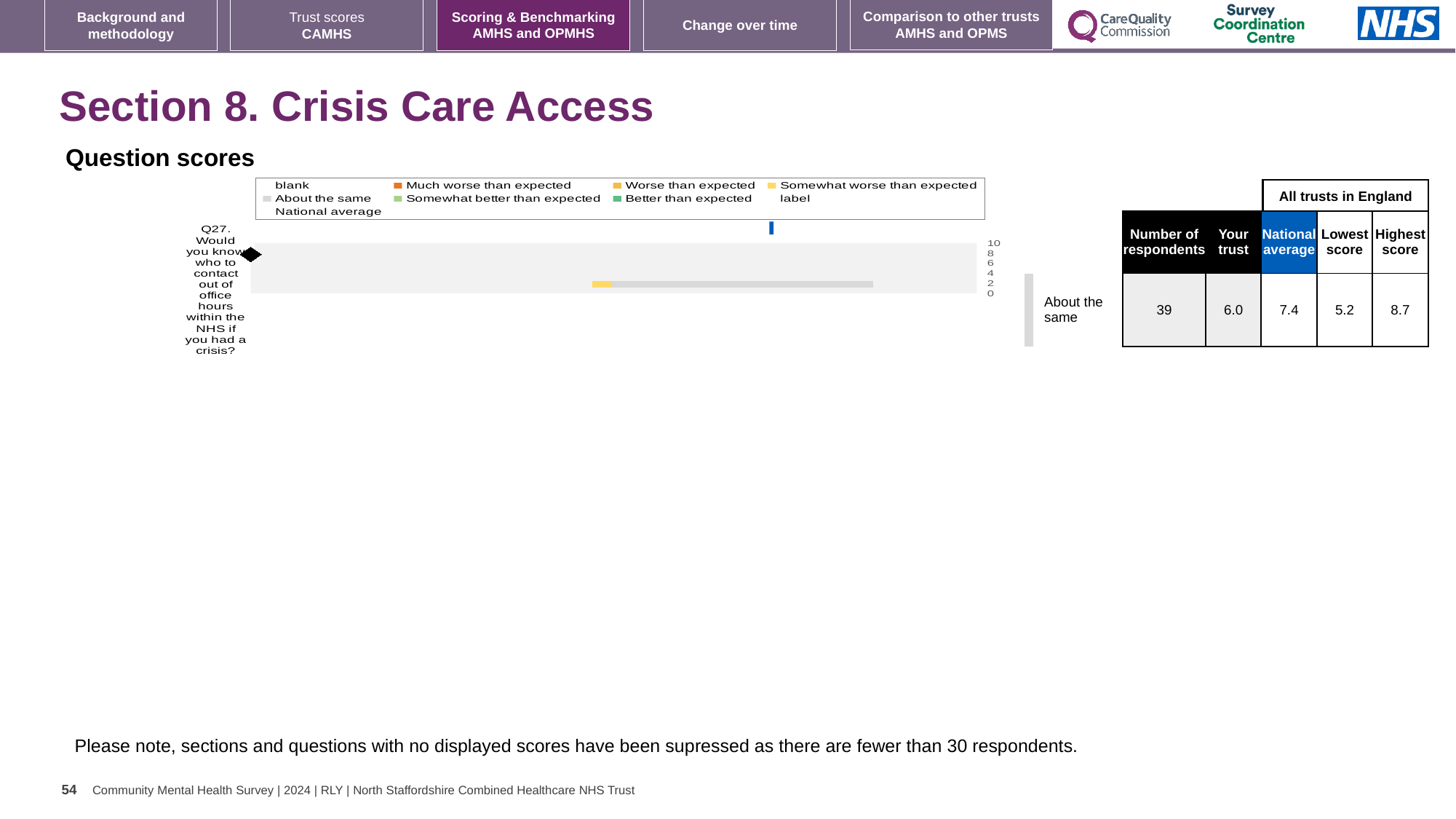
What is the lowest score among all trusts in England for Q27? 5.2 What is the national average score for Q27? 7.4 Which is larger for Q27, the trust's score or the national average? national average What is the highest value shown on the score axis of the Question scores chart? 10 What is the difference between the national average and the trust's score for Q27? 1.4 What is the trust's score for Q27? 6.0 How many questions are plotted in the Question scores chart? 1 What is the highest score among all trusts in England for Q27? 8.7 What benchmark category is shown for Q27 in the Question scores chart? About the same How many respondents answered Q27? 39 What kind of chart is used to show the question scores for Section 8? bar chart Which question is plotted in the Question scores chart? Q27. Would you know who to contact out of office hours within the NHS if you had a crisis?